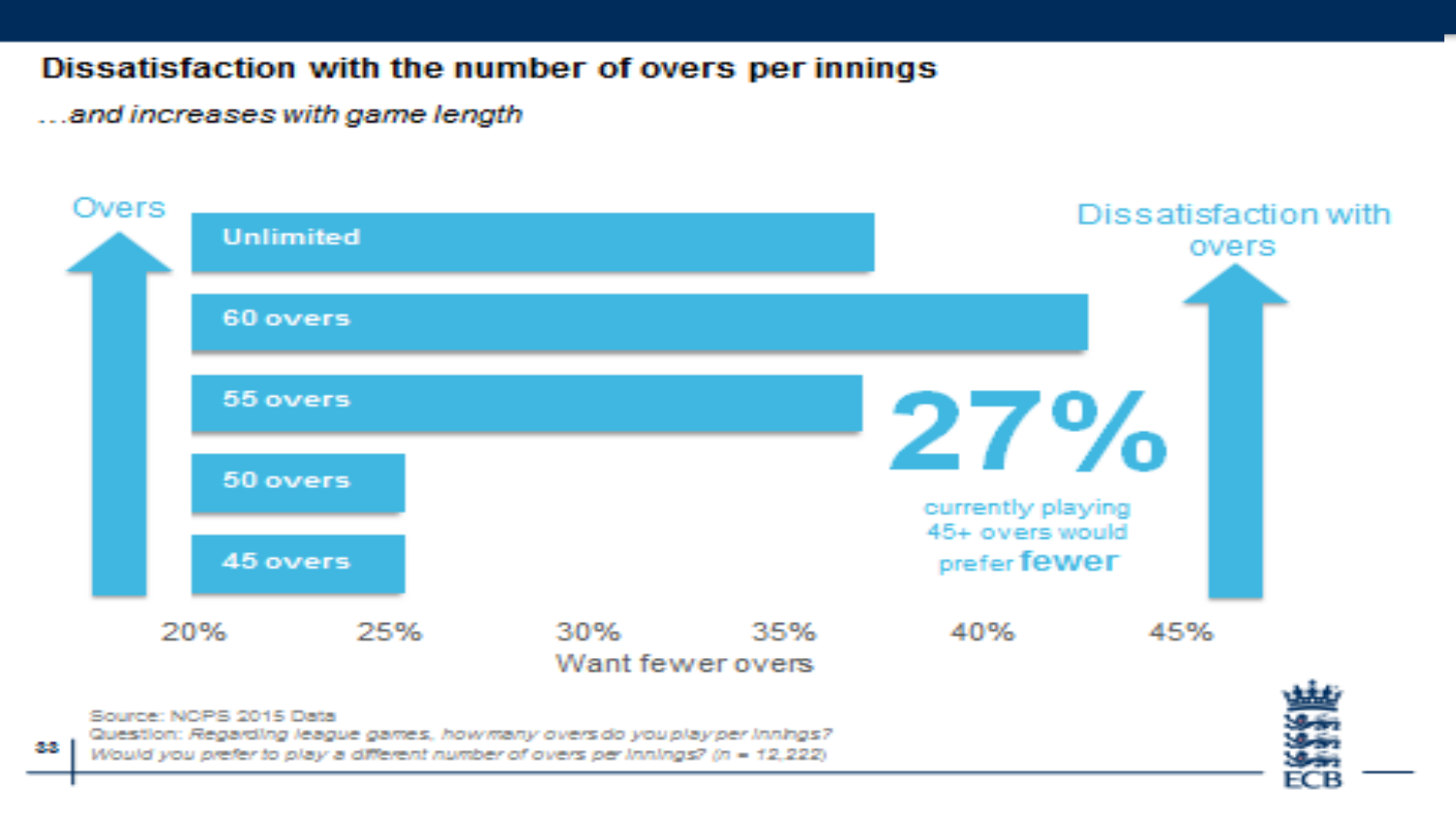
What kind of chart is shown on the slide? bar chart What is the label on the horizontal axis of the chart? Want fewer overs Is the value for 55 overs greater or less than 30%? greater Is the value for Unlimited greater or less than 35%? greater How many categories of overs are plotted in the bar chart? 5 Is the value for 45 overs greater or less than 30%? less Which is larger, the value for 60 overs or the value for 50 overs? 60 overs Which is larger, the value for Unlimited or the value for 45 overs? Unlimited Which category has the highest share wanting fewer overs? 60 overs Going from 45 overs up to 60 overs, does the share wanting fewer overs rise or fall? rise